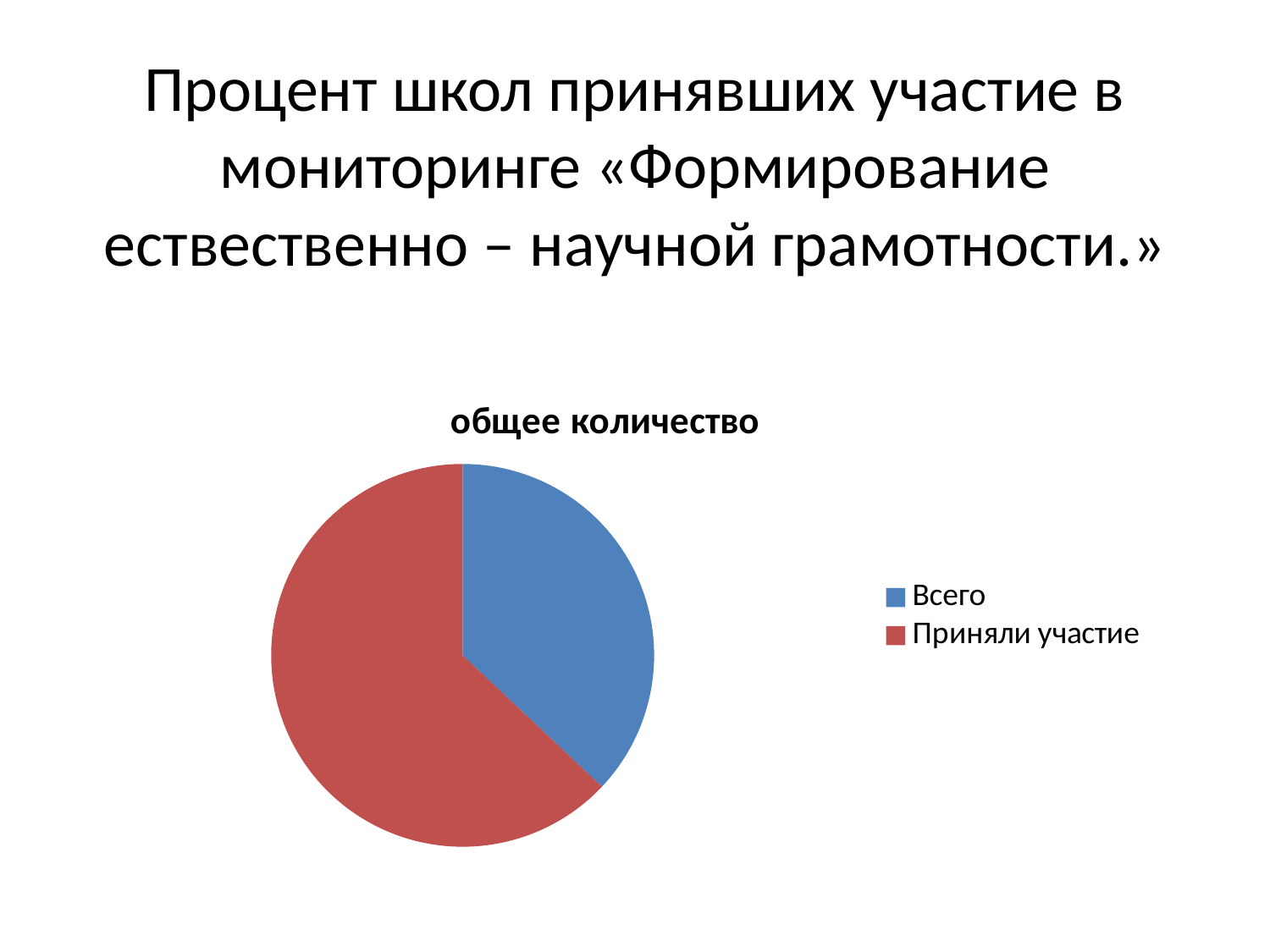
Which slice is the smallest in the pie chart? Всего What colour is the slice for Приняли участие? red How many entries does the legend list? 2 Which slice is larger, Всего or Приняли участие? Приняли участие What kind of chart is shown on the slide? pie chart What is the title of the chart? общее количество Which slice is the largest in the pie chart? Приняли участие How many slices does the pie chart have? 2